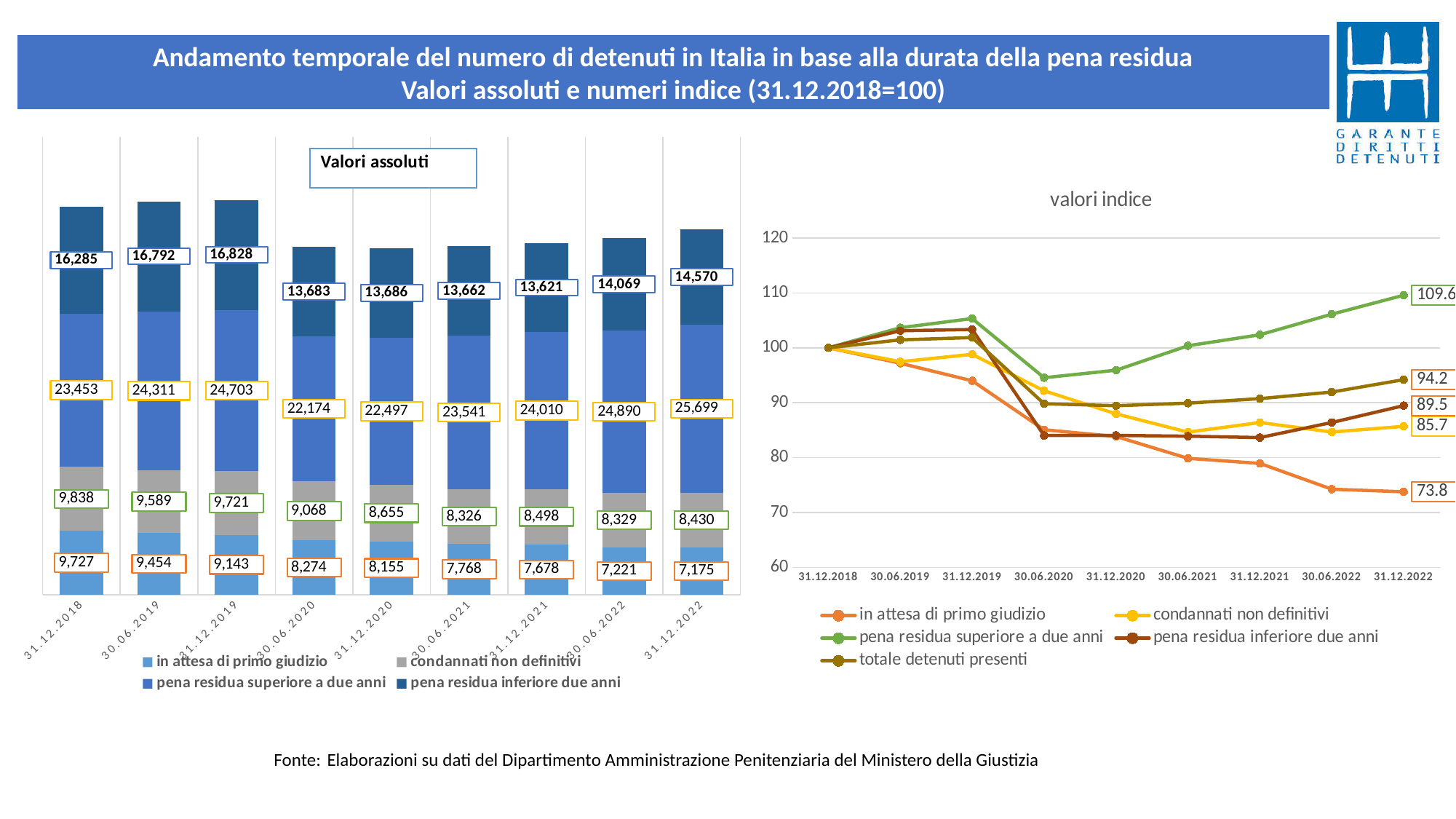
In the 'Valori assoluti' chart, what is the value for 'pena residua superiore a due anni' at 31.12.2022? 25,699 In the 'Valori assoluti' chart, what is the value for 'in attesa di primo giudizio' at 31.12.2018? 9,727 In the 'valori indice' chart, what is the value for 'in attesa di primo giudizio' at 31.12.2022? 73.8 In the 'valori indice' chart, does the 'in attesa di primo giudizio' line rise or fall from 31.12.2018 to 31.12.2022? Fall In the 'Valori assoluti' chart, how many series does the legend list? 4 In the 'Valori assoluti' chart, what is the total of the stacked bar for 31.12.2022? 55,874 What kind of chart is the 'Valori assoluti' chart? Stacked bar chart In the 'Valori assoluti' chart, at which date is 'in attesa di primo giudizio' lowest? 31.12.2022 In the 'Valori assoluti' chart, at which date is 'pena residua inferiore due anni' highest? 31.12.2019 In the 'Valori assoluti' chart, how many dates are shown on the x axis? 9 In the 'valori indice' chart, how many series does the legend list? 5 In the 'Valori assoluti' chart, what is the difference between 'condannati non definitivi' at 31.12.2018 and at 31.12.2022? 1,408